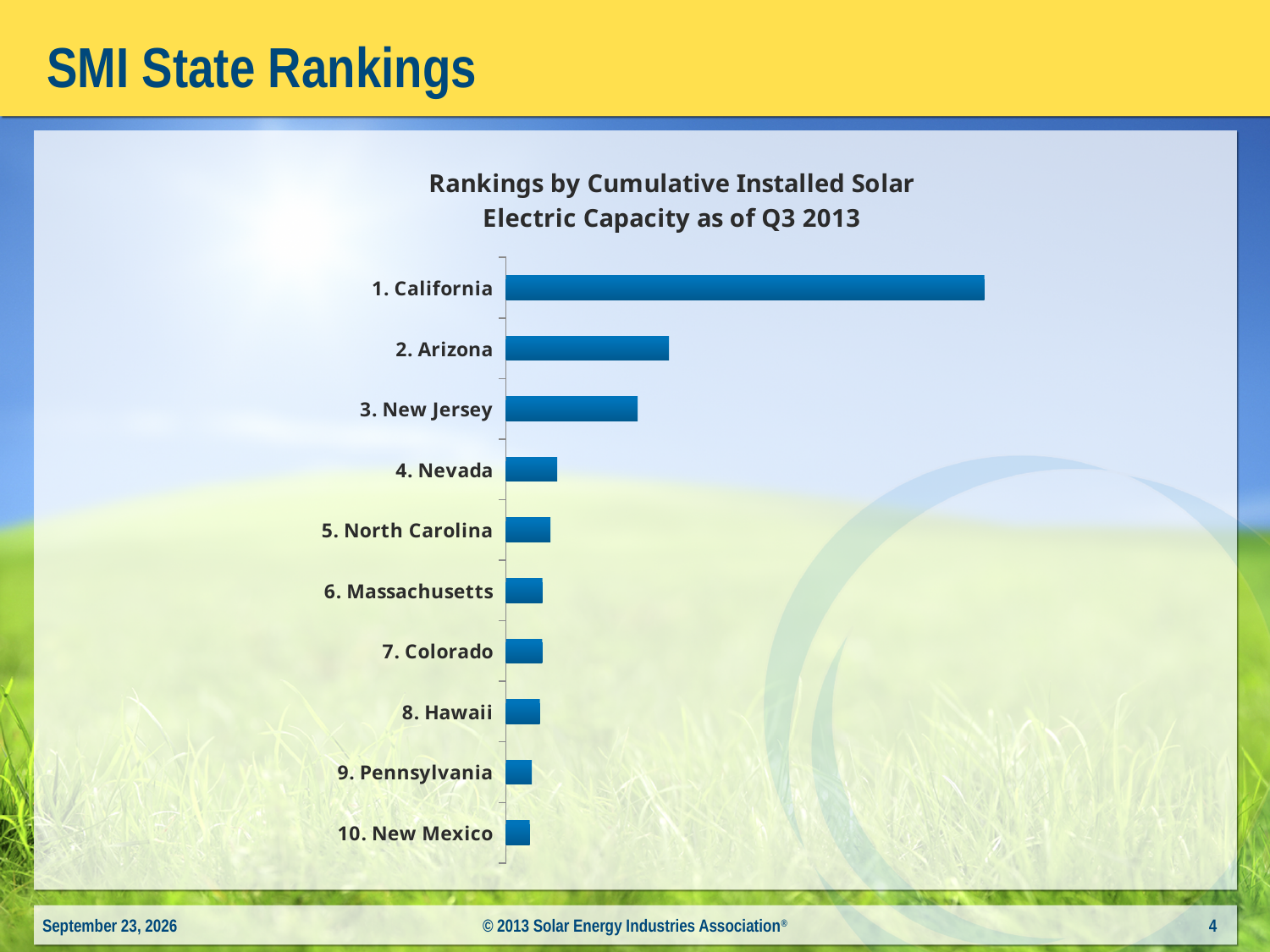
Do the bars get longer or shorter going from the top of the chart to the bottom? shorter Which has the longer bar, 3. New Jersey or 10. New Mexico? 3. New Jersey Which has the longer bar, 1. California or 3. New Jersey? 1. California Which state has the highest cumulative installed solar electric capacity in the chart? 1. California Which has the longer bar, 2. Arizona or 4. Nevada? 2. Arizona What kind of chart is shown on the slide? bar chart How many states are listed in the chart? 10 What is the title of the chart? Rankings by Cumulative Installed Solar Electric Capacity as of Q3 2013 Which state is ranked 5th in the chart? North Carolina